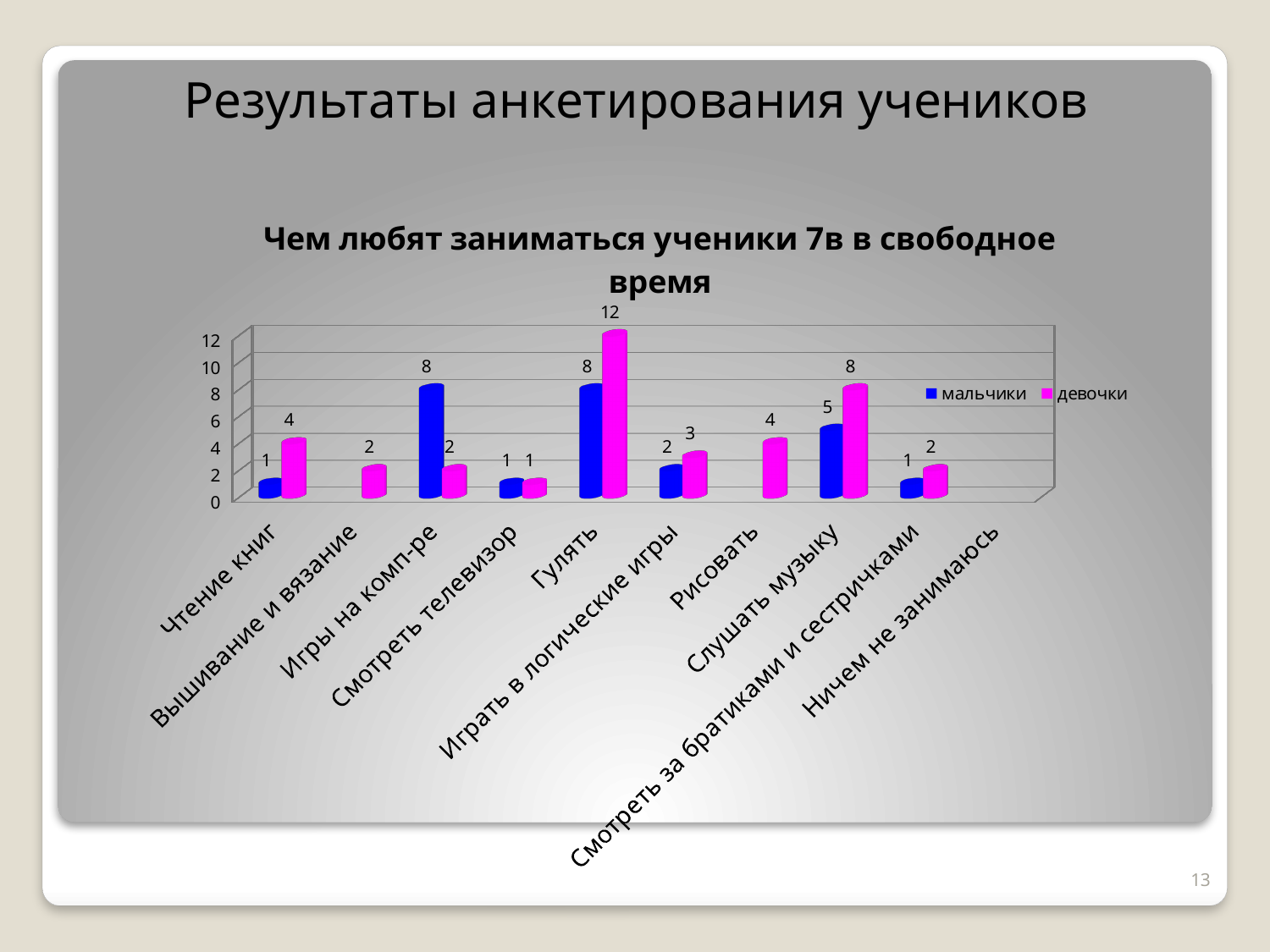
What type of chart is shown on the slide? bar chart What is the difference between девочки and мальчики in the category Гулять? 4 Which is larger in the category Игры на комп-ре: мальчики or девочки? мальчики How many series does the legend list? 2 What is the value for девочки in the category Гулять? 12 Which category has the highest value for девочки? Гулять What is the title of the chart? Чем любят заниматься ученики 7в в свободное время What is the value for мальчики in the category Слушать музыку? 5 What is the value for девочки in the category Чтение книг? 4 How many categories are shown on the x axis? 10 What is the difference between девочки and мальчики in the category Слушать музыку? 3 What is the value for мальчики in the category Игры на комп-ре? 8